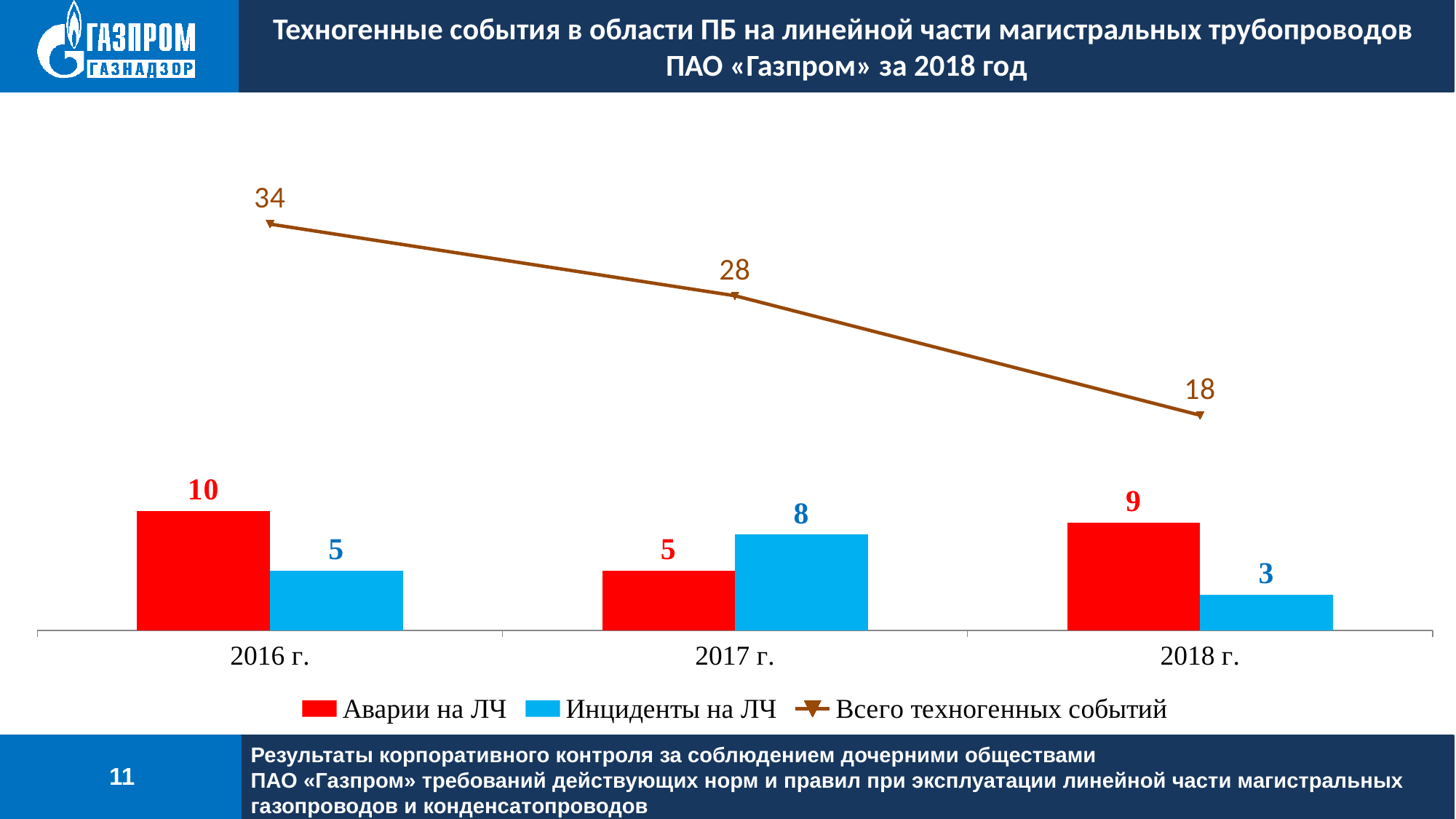
Which year has the lowest value for «Инциденты на ЛЧ»? 2018 г. Which year has the highest value for «Всего техногенных событий»? 2016 г. What is the difference between «Аварии на ЛЧ» and «Инциденты на ЛЧ» in 2018 г.? 6 Which is larger in 2017 г.: «Аварии на ЛЧ» or «Инциденты на ЛЧ»? Инциденты на ЛЧ What is the value of «Всего техногенных событий» for 2018 г.? 18 What is the value of «Аварии на ЛЧ» for 2016 г.? 10 Does «Всего техногенных событий» rise or fall from 2016 г. to 2018 г.? Fall What is the value of «Инциденты на ЛЧ» for 2017 г.? 8 What is the difference between «Всего техногенных событий» in 2016 г. and 2018 г.? 16 How many series does the legend list? 3 How many years are shown on the x axis? 3 What kind of chart is this? Combined bar and line chart